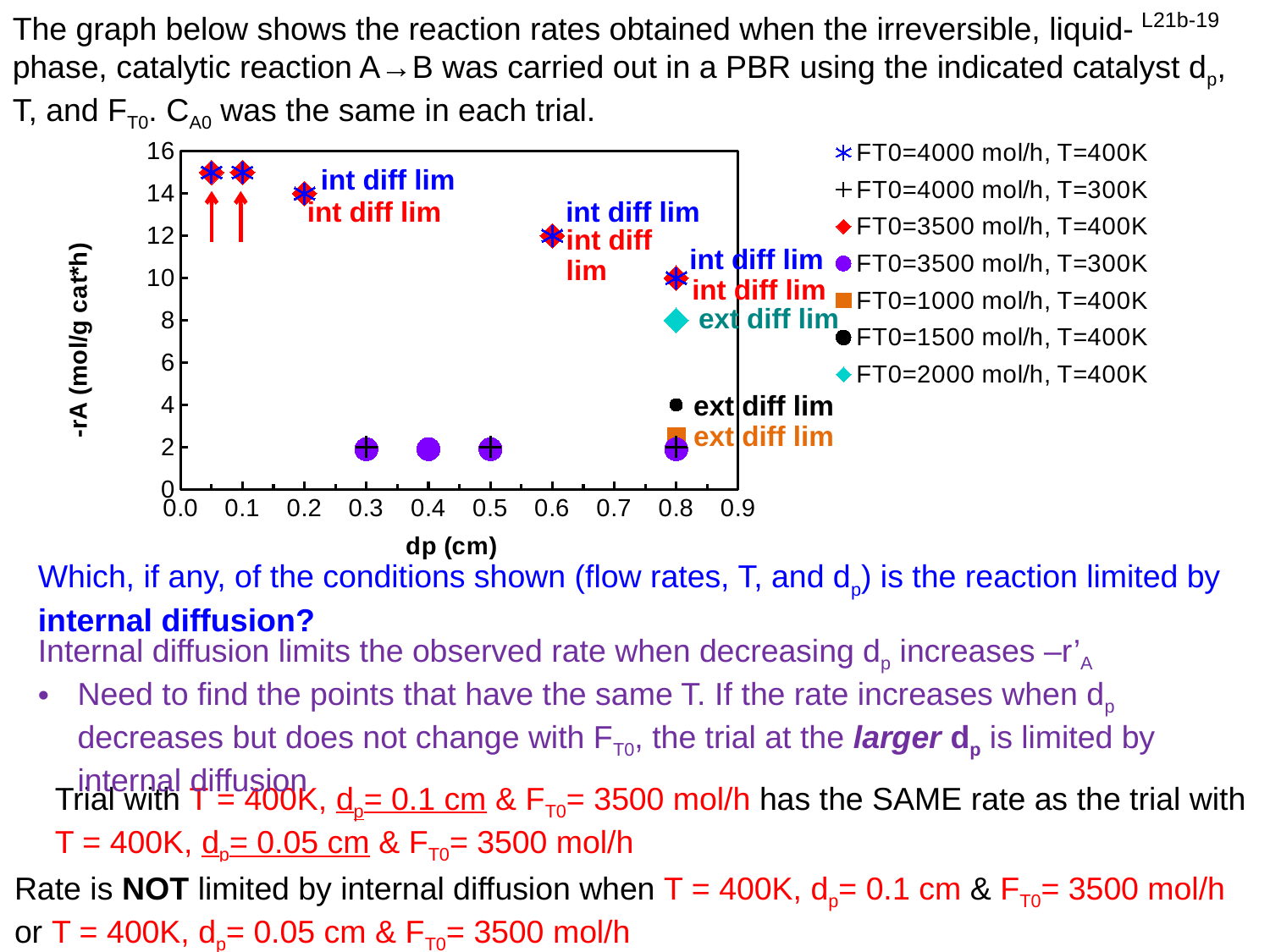
Which is larger at dp = 0.8 cm: the value for FT0=2000 mol/h, T=400K or the value for FT0=1500 mol/h, T=400K? FT0=2000 mol/h, T=400K What is the title of the chart's y axis? -rA (mol/g cat*h) Is the value for the FT0=1500 mol/h, T=400K point at dp = 0.8 cm greater or less than 6? less Is the value for the FT0=3500 mol/h, T=400K point at dp = 0.8 cm greater or less than 12? less What is the title of the chart's x axis? dp (cm) Is the value for the FT0=4000 mol/h, T=400K point at dp = 0.05 cm greater or less than 14? greater How many series does the chart legend list? 7 For the T=400K trials with FT0=3500 mol/h, do the reaction rates rise or fall as dp increases from 0.2 cm to 0.8 cm? fall What kind of chart is shown on the slide? scatter chart